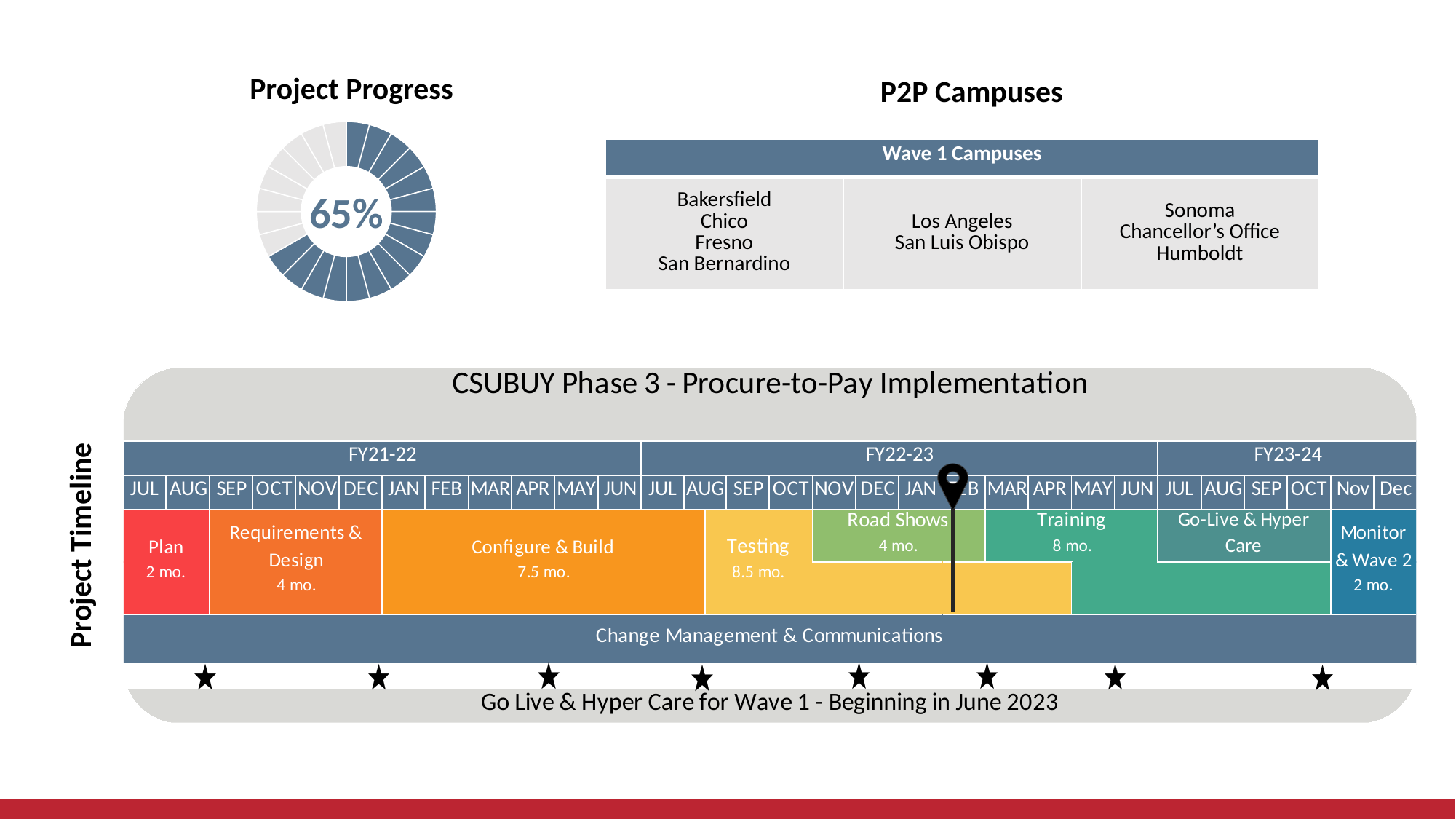
On the Project Timeline, how many months is the Testing phase? 8.5 mo. On the Project Progress chart, what share of the donut remains unfilled (grey)? 35% On the Project Progress chart, what share of the donut is filled in blue? 65% On the Project Progress chart, is the completed share greater or less than 50%? greater On the Project Timeline, how many months is the Configure & Build phase? 7.5 mo. On the Project Progress chart, what percentage is shown in the centre of the donut? 65% What kind of chart is the Project Progress chart? Donut (pie) chart On the Project Timeline, which phase is longer: Training or Requirements & Design? Training On the Project Timeline, how much longer is the Testing phase than the Configure & Build phase? 1 mo. On the Project Timeline, which phase has the longest printed duration? Testing What is the title of the donut chart on the slide? Project Progress On the Project Timeline, how many fiscal years are shown across the top of the timeline? 3